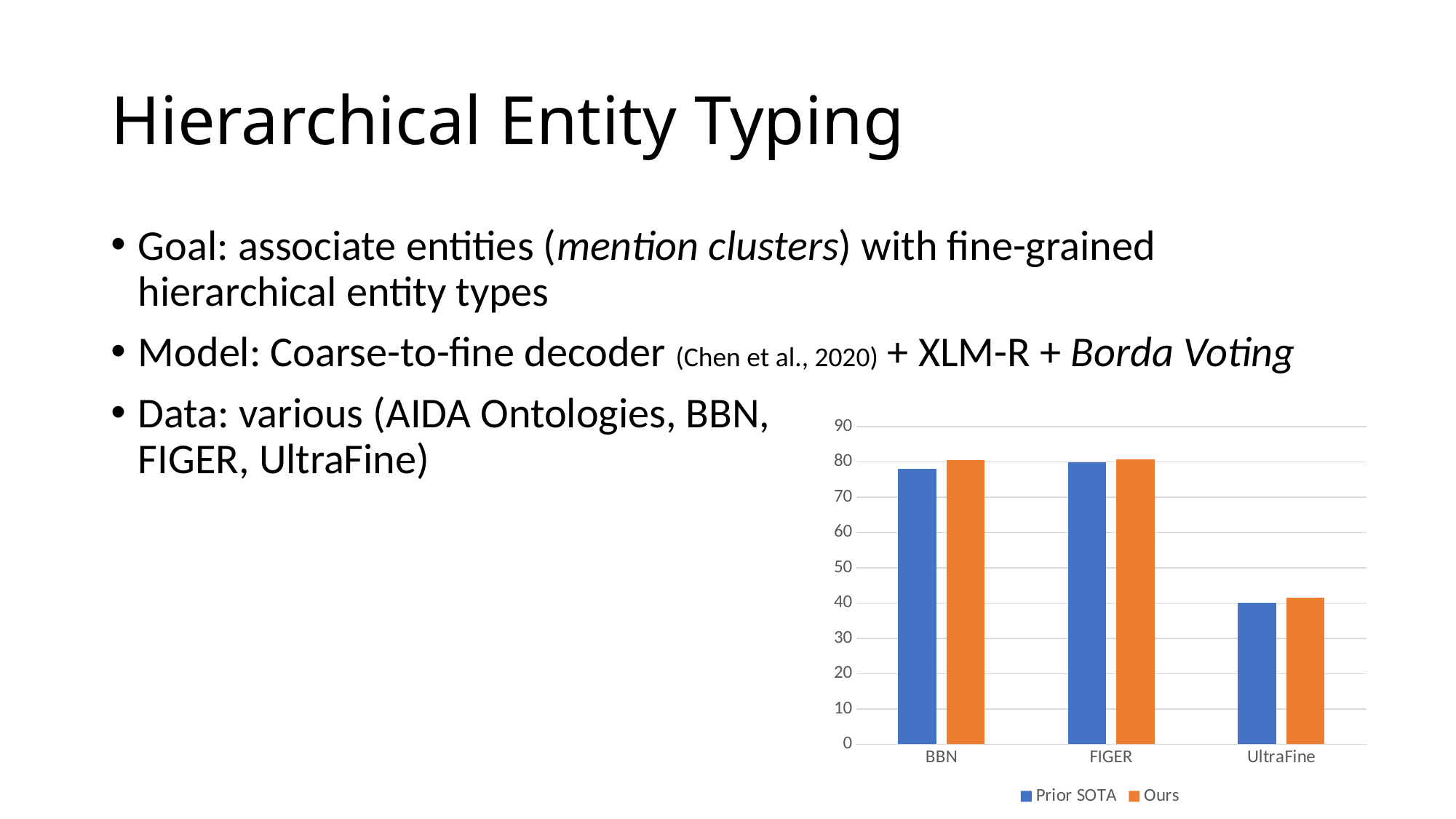
For BBN, which is larger: Prior SOTA or Ours? Ours Is the Prior SOTA value for BBN greater or less than 70? greater Is the Ours value for BBN greater or less than 90? less Which category has the lowest values in the chart? UltraFine How many categories are shown on the x axis of the chart? 3 What colour are the bars for the Ours series? orange Is the Ours value for UltraFine greater or less than 30? greater How many series does the chart's legend list? 2 What are the two series named in the chart's legend? Prior SOTA and Ours What kind of chart is shown on the slide? bar chart